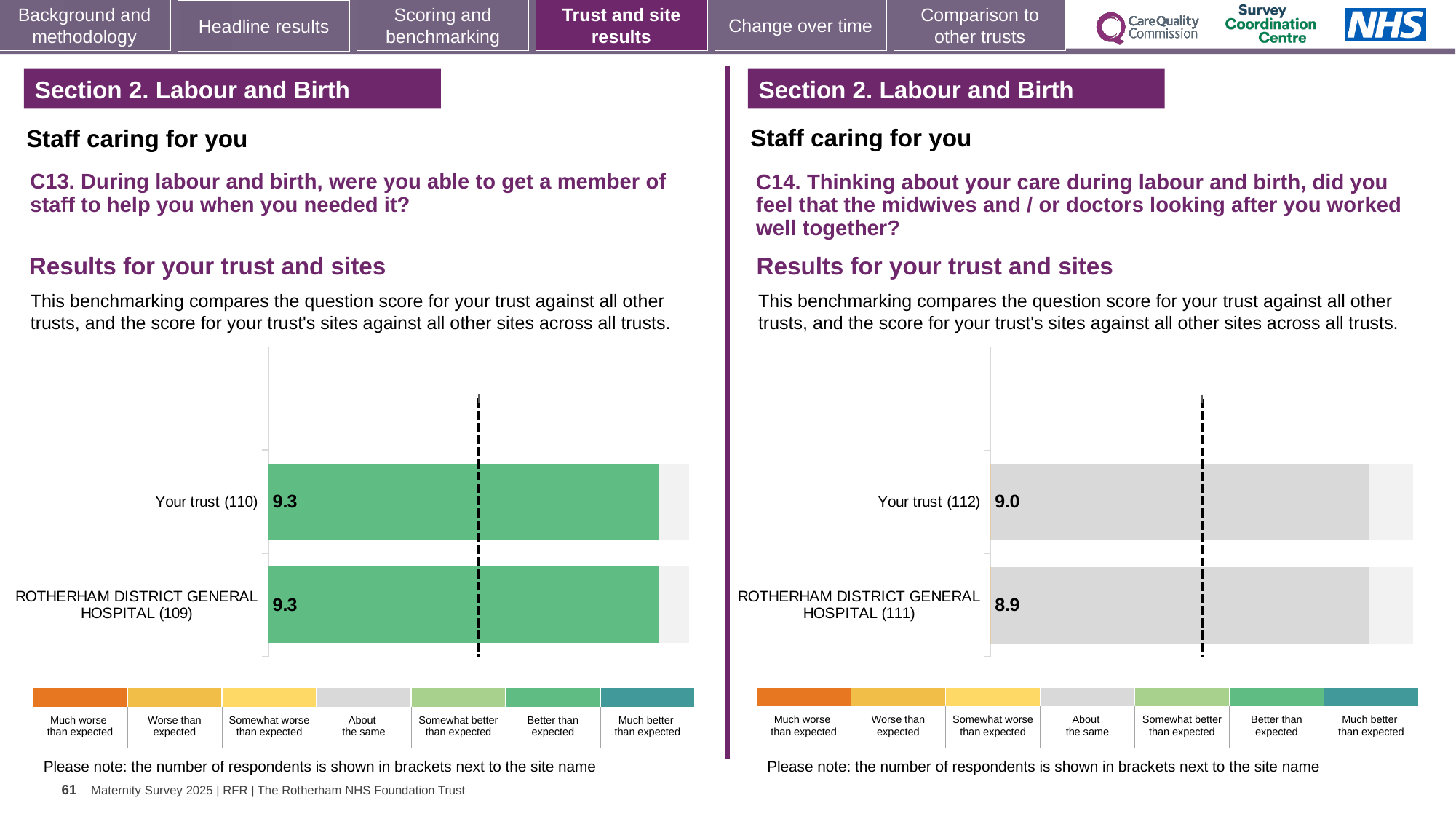
What type of chart is used for the C14 results on the right? Bar chart In the C14 chart on the right, which category has the lowest score? ROTHERHAM DISTRICT GENERAL HOSPITAL (111) In the C13 chart on the left, which benchmark category does the colour of the bars correspond to according to the legend? Better than expected In the C13 chart on the left, what is the score for ROTHERHAM DISTRICT GENERAL HOSPITAL (109)? 9.3 In the C13 chart on the left, what is the score for Your trust (110)? 9.3 In the C14 chart on the right, which has the higher score, Your trust or ROTHERHAM DISTRICT GENERAL HOSPITAL? Your trust In the C14 chart on the right, which benchmark category does the colour of the bars correspond to according to the legend? About the same In the C14 chart on the right, what is the score for ROTHERHAM DISTRICT GENERAL HOSPITAL (111)? 8.9 How many bars are plotted in the C13 chart on the left? 2 In the C14 chart on the right, what is the score for Your trust (112)? 9.0 In the C13 chart on the left, how many respondents are shown in brackets for Your trust? 110 In the C14 chart on the right, what is the difference between the score for Your trust and the score for ROTHERHAM DISTRICT GENERAL HOSPITAL? 0.1